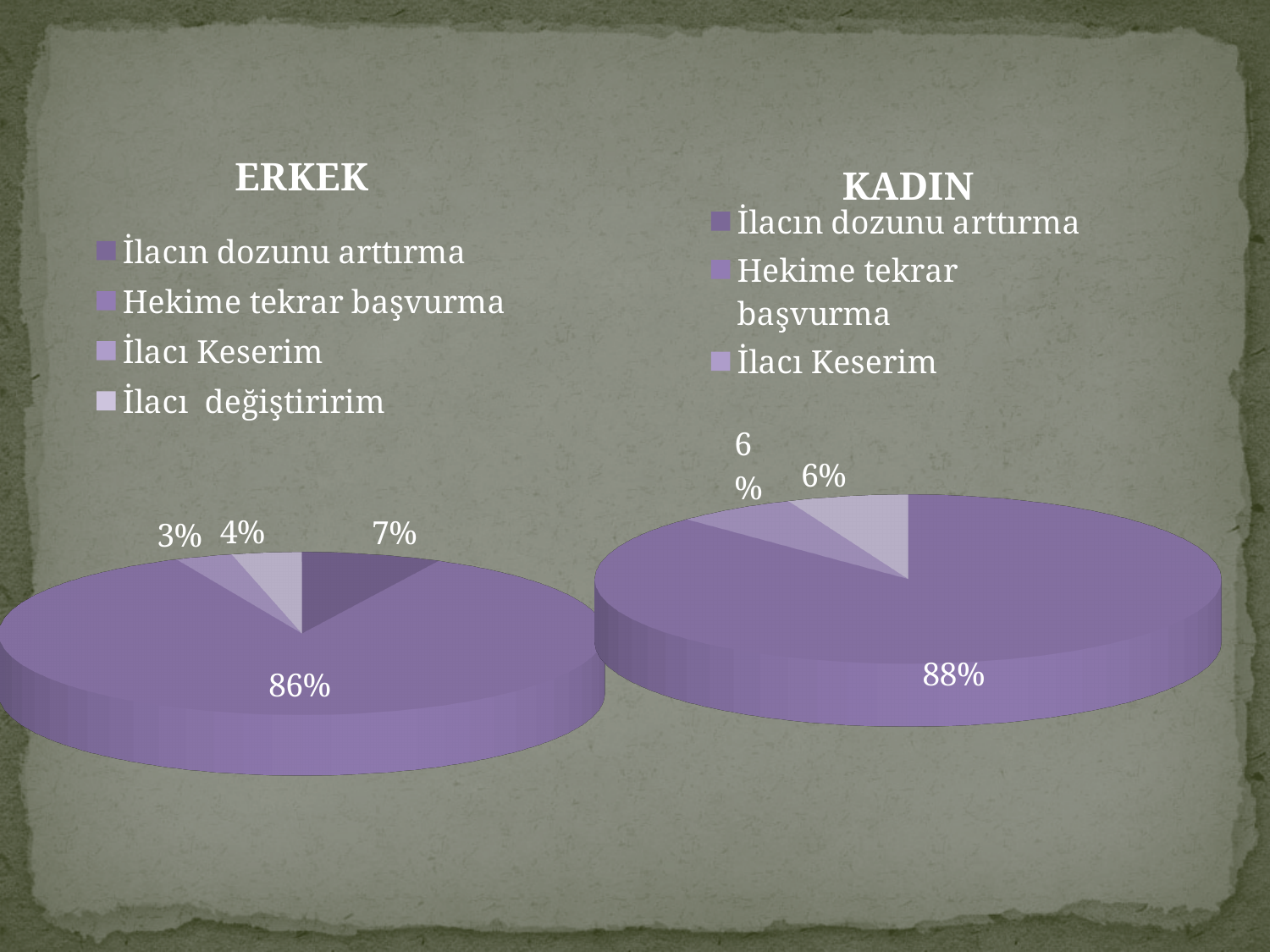
In the KADIN chart, what share does Hekime tekrar başvurma have? 88% In the ERKEK chart, what share does İlacın dozunu arttırma have? 7% How many categories does the legend of the ERKEK chart list? 4 What is the title of the chart on the right side of the slide? KADIN In the ERKEK chart, what share does Hekime tekrar başvurma have? 86% What kind of chart is the ERKEK chart? pie chart Which is larger: the share of Hekime tekrar başvurma in the ERKEK chart or in the KADIN chart? KADIN In the ERKEK chart, what is the difference between the shares of Hekime tekrar başvurma and İlacın dozunu arttırma? 79% Which category has the largest slice in the KADIN chart? Hekime tekrar başvurma Which category has the largest slice in the ERKEK chart? Hekime tekrar başvurma How many categories does the legend of the KADIN chart list? 3